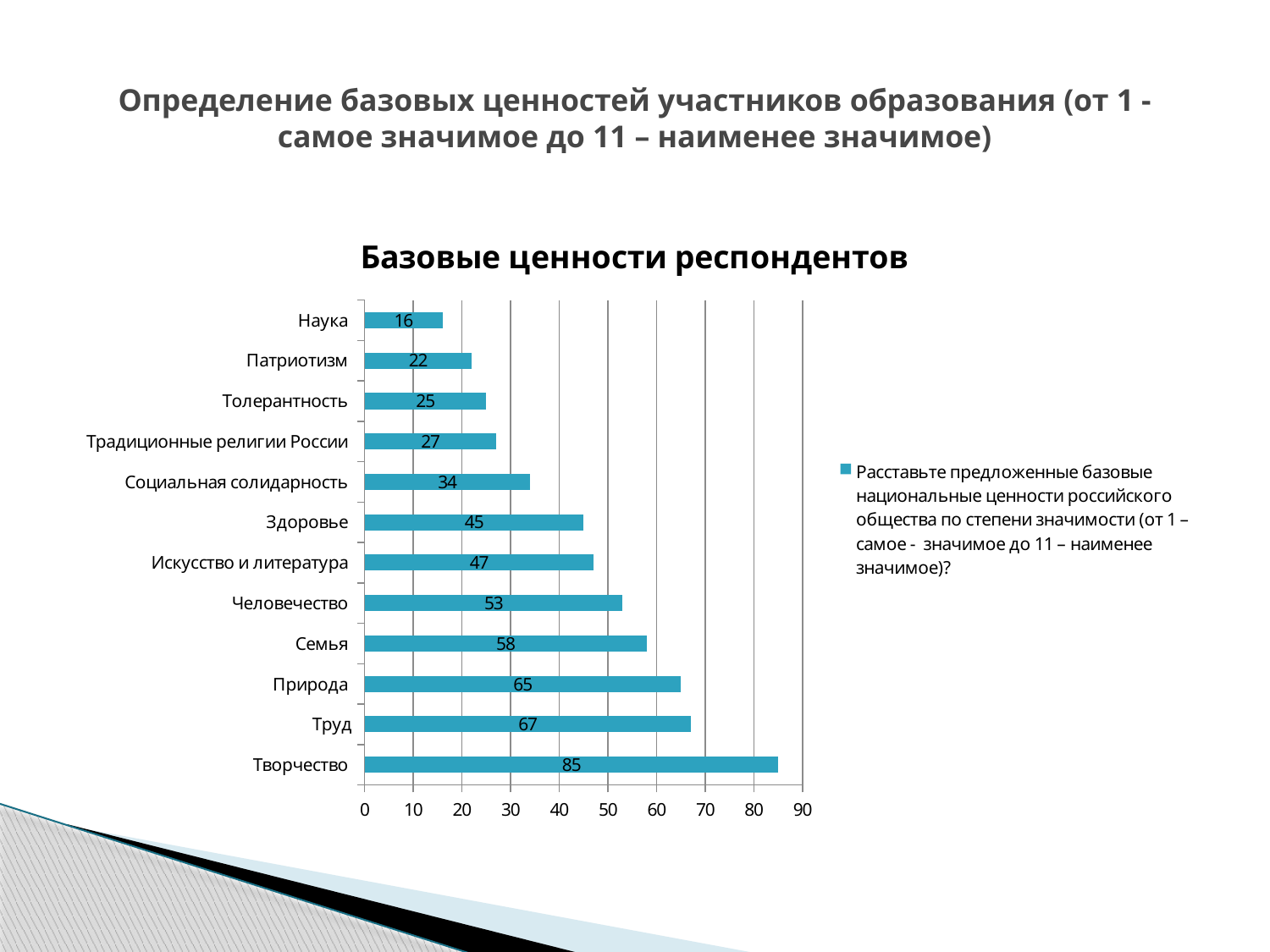
What is the difference between the values for Труд and Природа? 2 What is the value for Традиционные религии России? 27 What is the difference between the values for Семья and Наука? 42 Which category has the highest value? Творчество What is the value for Здоровье? 45 What is the value for Творчество? 85 Which is larger, the value for Человечество or the value for Искусство и литература? Человечество How many categories are shown in the chart? 12 What kind of chart is shown on the slide? bar chart Which category has the lowest value? Наука Is the value for Социальная солидарность greater or less than 30? greater What is the title of the chart? Базовые ценности респондентов